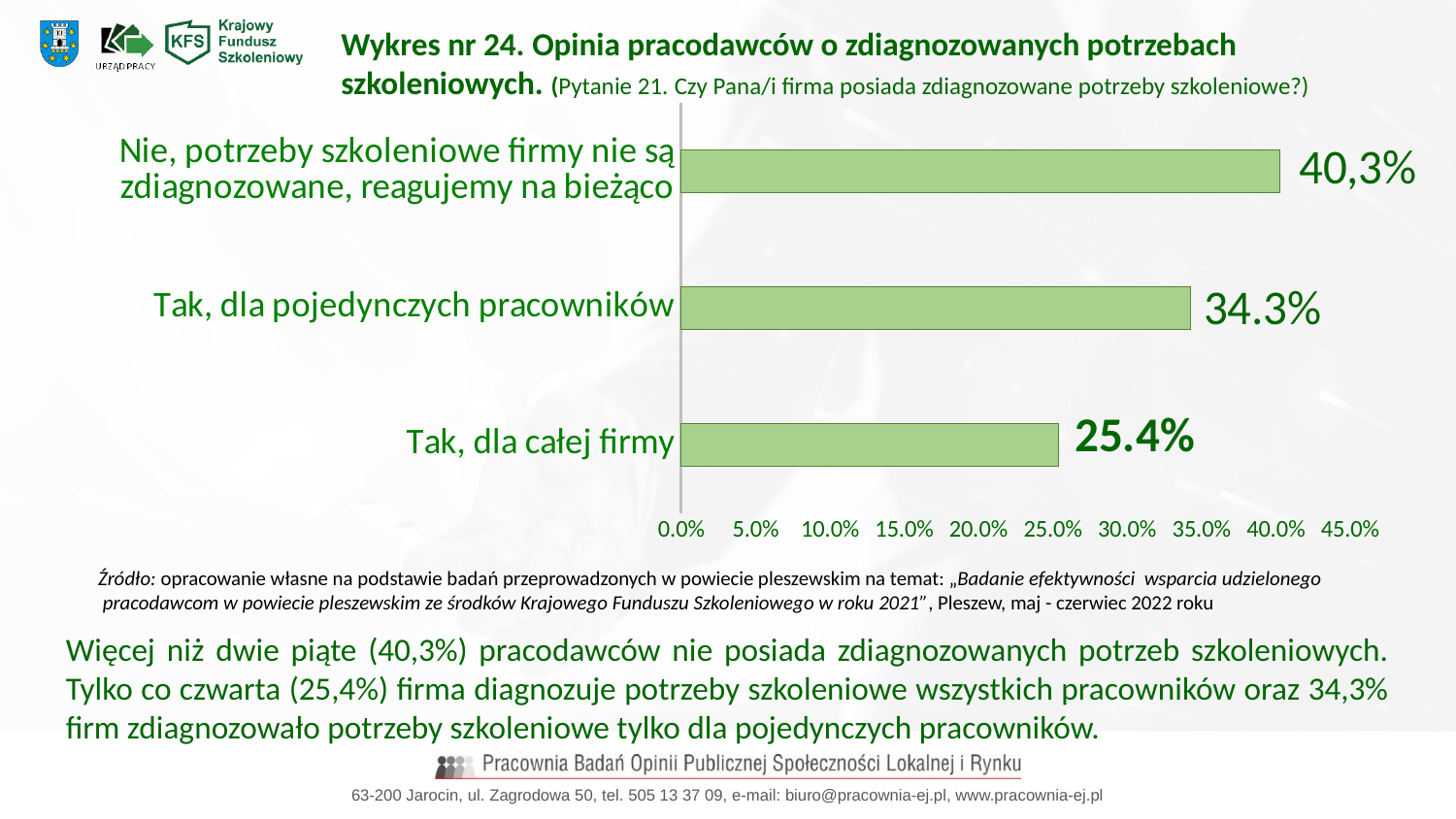
What is the value for "Tak, dla pojedynczych pracowników"? 34.3% How many categories are shown in the chart? 3 What is the highest value shown on the x axis? 45.0% What is the number of the chart given in its title? 24 Is the value for "Nie, potrzeby szkoleniowe firmy nie są zdiagnozowane, reagujemy na bieżąco" greater or less than 35.0%? greater What kind of chart is shown on the slide? bar chart Which category has the highest value? Nie, potrzeby szkoleniowe firmy nie są zdiagnozowane, reagujemy na bieżąco Which is larger: the value for "Tak, dla pojedynczych pracowników" or the value for "Tak, dla całej firmy"? Tak, dla pojedynczych pracowników Is the value for "Tak, dla całej firmy" greater or less than 30.0%? less Which category has the lowest value? Tak, dla całej firmy What is the value for "Nie, potrzeby szkoleniowe firmy nie są zdiagnozowane, reagujemy na bieżąco"? 40,3% What is the value for "Tak, dla całej firmy"? 25.4%